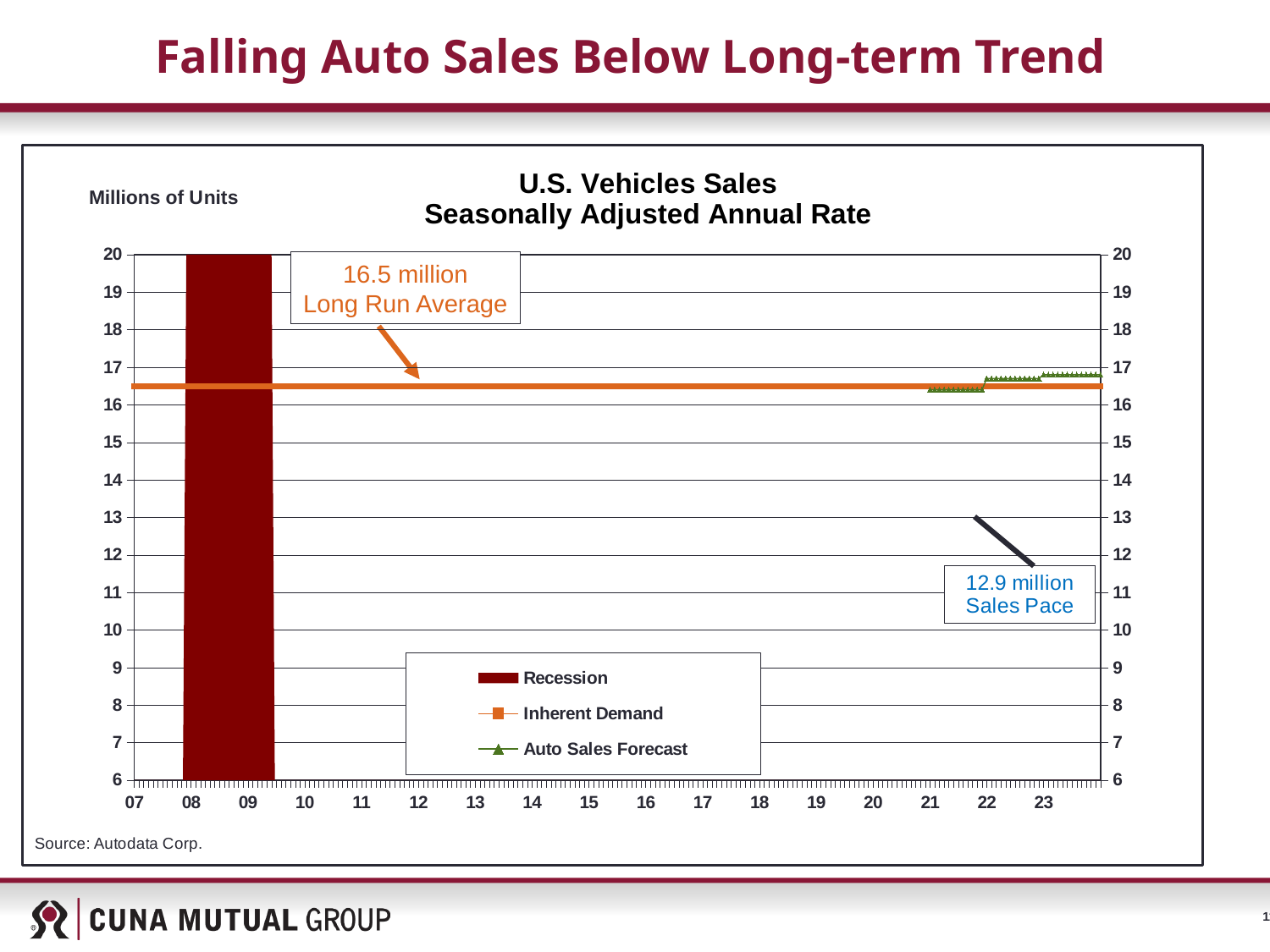
What sales pace value is labelled on the chart? 12.9 million In 23, is the Auto Sales Forecast above or below the Inherent Demand line? above What is the title of the chart? U.S. Vehicles Sales Seasonally Adjusted Annual Rate Is the Auto Sales Forecast value in 23 greater or less than 17? less In 21, is the Auto Sales Forecast above or below the Inherent Demand line? below Does the Auto Sales Forecast line rise or fall from 21 to 23? rise How many series does the chart legend list? 3 What unit is the y axis of the chart measured in? Millions of Units What is the highest value shown on the y axis of the chart? 20 What is the long run average value labelled on the chart? 16.5 million Is the Auto Sales Forecast value in 23 greater or less than 16? greater At what level does the Inherent Demand line sit? 16.5 million